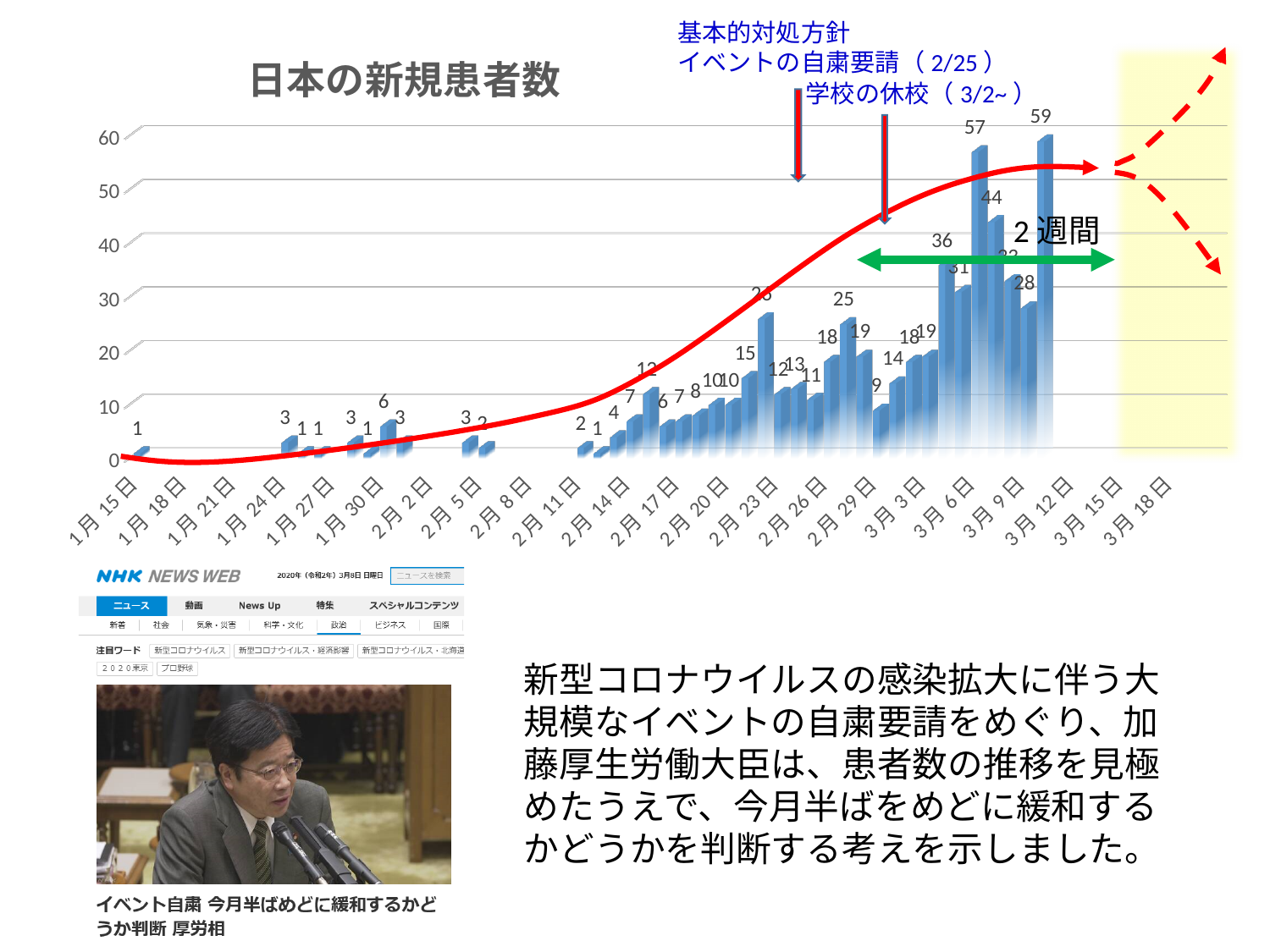
What is the highest value shown on the vertical axis? 60 What is the difference between the bars labeled 57 and 44? 13 Which is larger, the bar labeled 57 or the bar labeled 44? 57 What is the lowest daily value labeled on the chart? 1 Is the bar labeled 36 greater or less than 30? greater Overall, do the daily values rise or fall from January to March along the x axis? rise What is the highest daily value labeled on the chart? 59 What is the difference between the two highest labeled values, 59 and 57? 2 What is the title of the chart? 日本の新規患者数 Is the bar labeled 26 greater or less than 30? less What is the value of the first bar, on 1月15日? 1 What kind of chart is used to show the daily new patient counts? bar chart